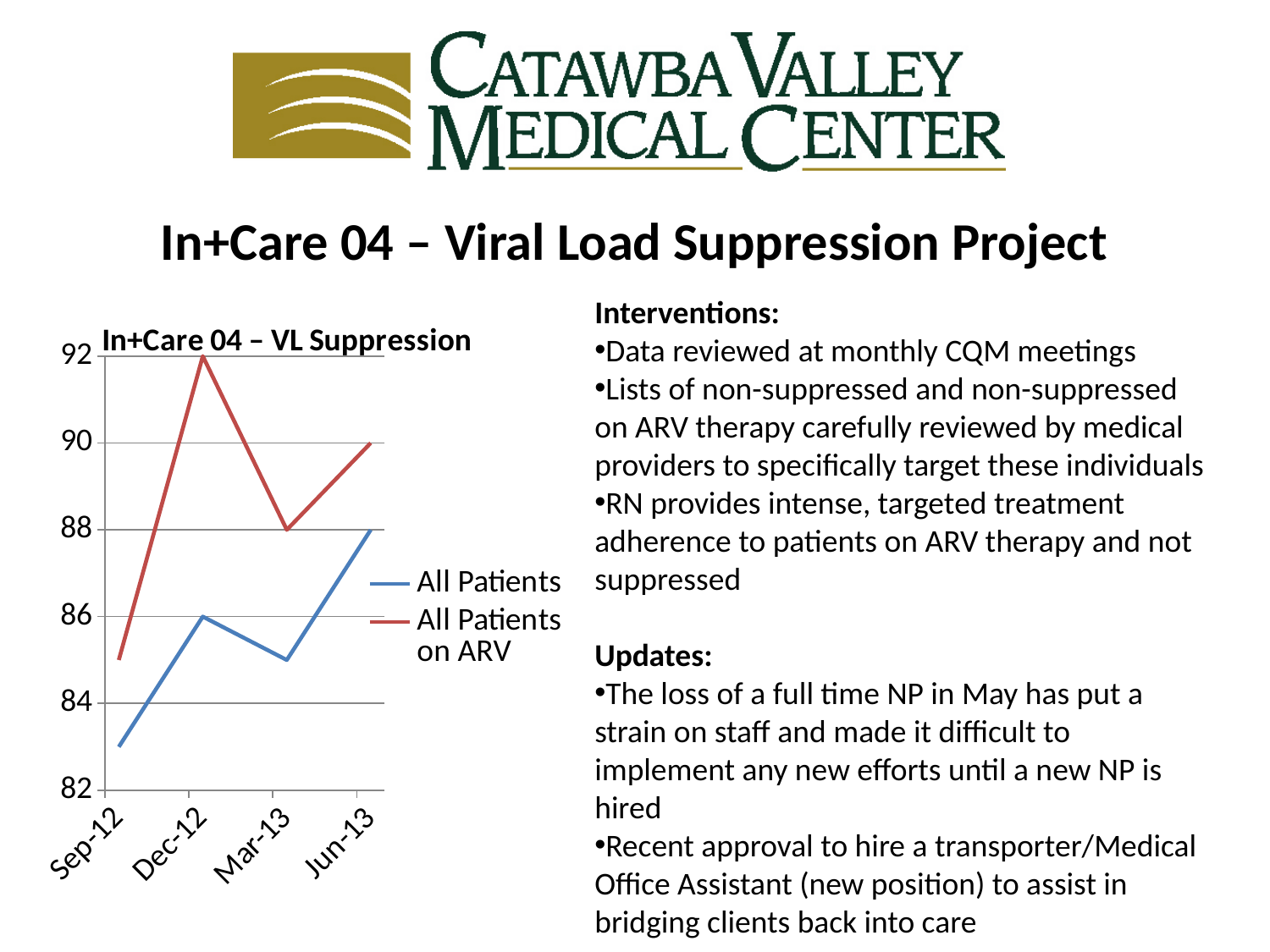
What type of chart is shown on the slide? line chart How many series does the chart legend list? 2 In which month is the All Patients series at its lowest value? Sep-12 What is the value for All Patients on ARV at Jun-13? 90 What is the title of the chart? In+Care 04 – VL Suppression At Mar-13, which series has the higher value, All Patients or All Patients on ARV? All Patients on ARV What is the value for All Patients on ARV at Dec-12? 92 In which month does the All Patients on ARV series reach its highest value? Dec-12 What is the value for All Patients at Jun-13? 88 What is the difference between the All Patients on ARV values at Dec-12 and Jun-13? 2 How many time points are plotted along the x axis? 4 Is the value for All Patients at Sep-12 greater or less than 84? less